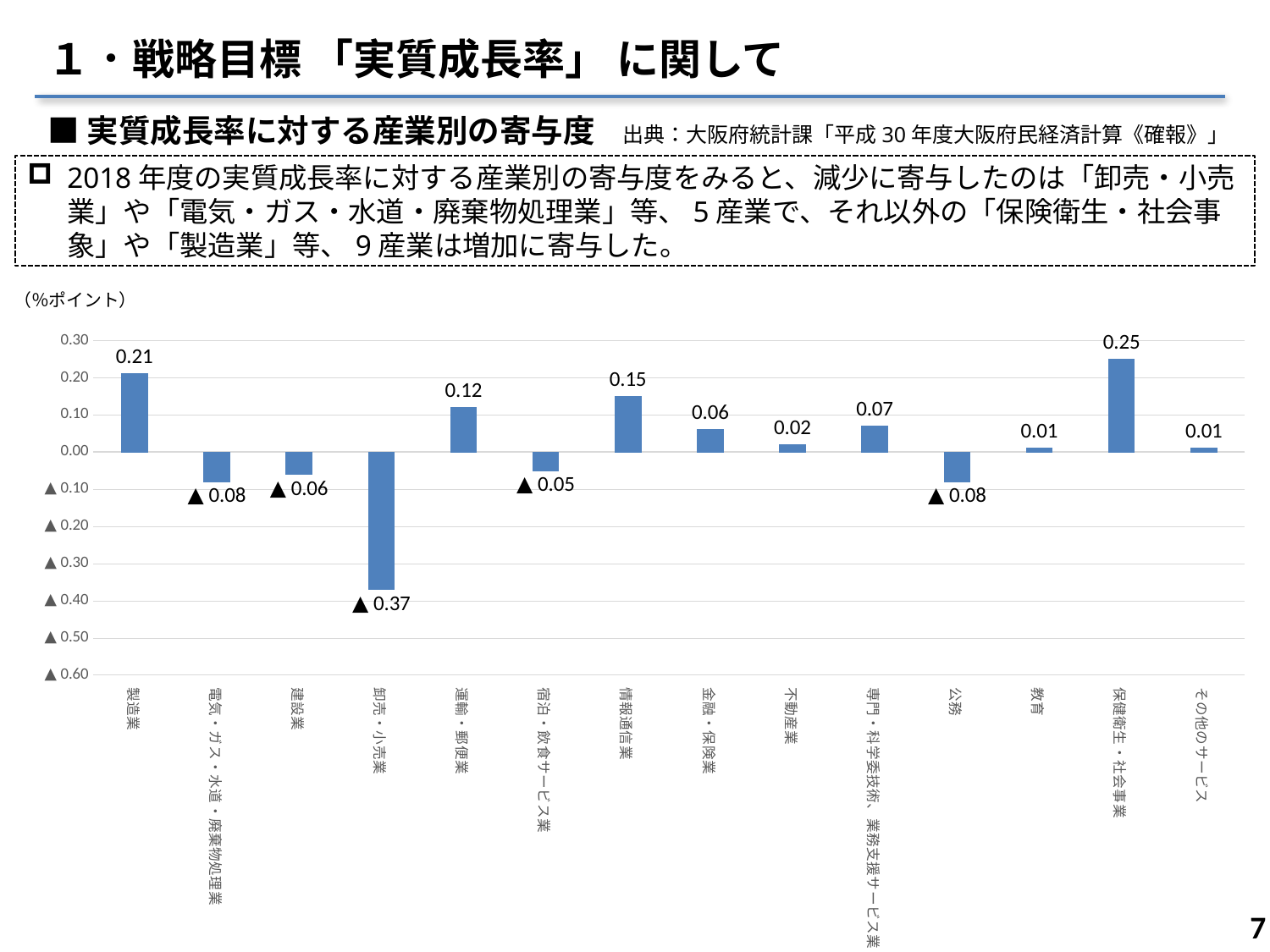
How many categories are shown on the x axis? 14 What is the value for 専門・科学技術、業務支援サービス業? 0.07 Which is larger, the value for 運輸・郵便業 or the value for 金融・保険業? 運輸・郵便業 What is the value for 情報通信業? 0.15 Which category has the lowest value? 卸売・小売業 What is the value for 公務? ▲ 0.08 What unit is shown above the chart's vertical axis? %ポイント Which category has the highest value? 保健衛生・社会事業 What is the difference between the values for 保健衛生・社会事業 and 製造業? 0.04 What is the value for 卸売・小売業? ▲ 0.37 What is the value for 製造業? 0.21 What kind of chart is shown on the slide? Bar chart